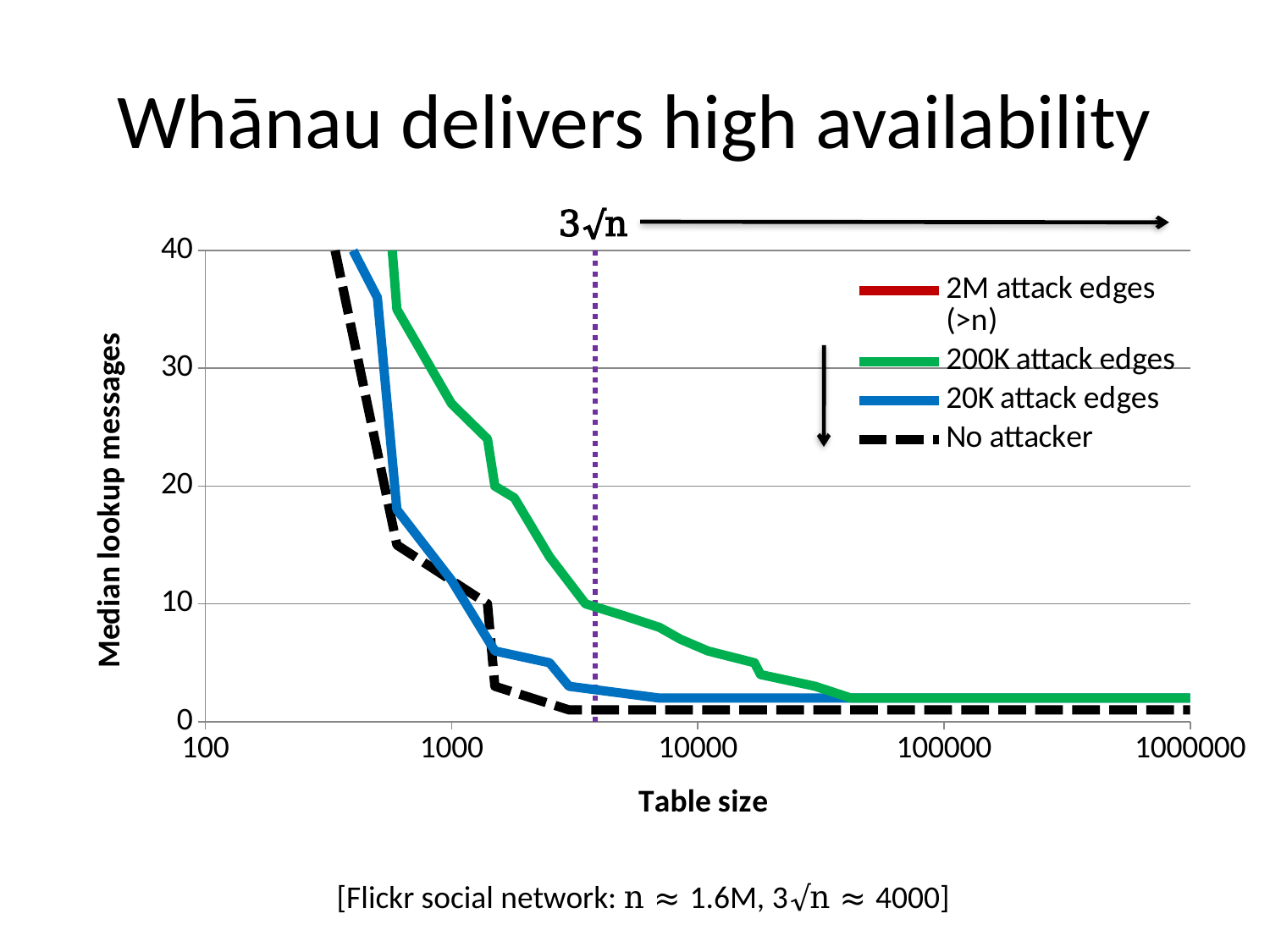
How many series does the legend list? 4 As table size increases along the x axis, do the median lookup messages rise or fall? fall At a table size of 1000, is the value for 200K attack edges greater or less than 20? greater What is the label of the y axis? Median lookup messages What is the title of the slide's chart? Whānau delivers high availability At a table size of 100000, is the value for No attacker greater or less than 10? less At a table size of 1000, which series has the higher value: 200K attack edges or 20K attack edges? 200K attack edges At a table size of 1000, is the value for 20K attack edges greater or less than 10? greater What is the highest value shown on the y axis? 40 What kind of chart is shown on the slide? line chart At a table size of 10000, which series has the higher value: 200K attack edges or No attacker? 200K attack edges